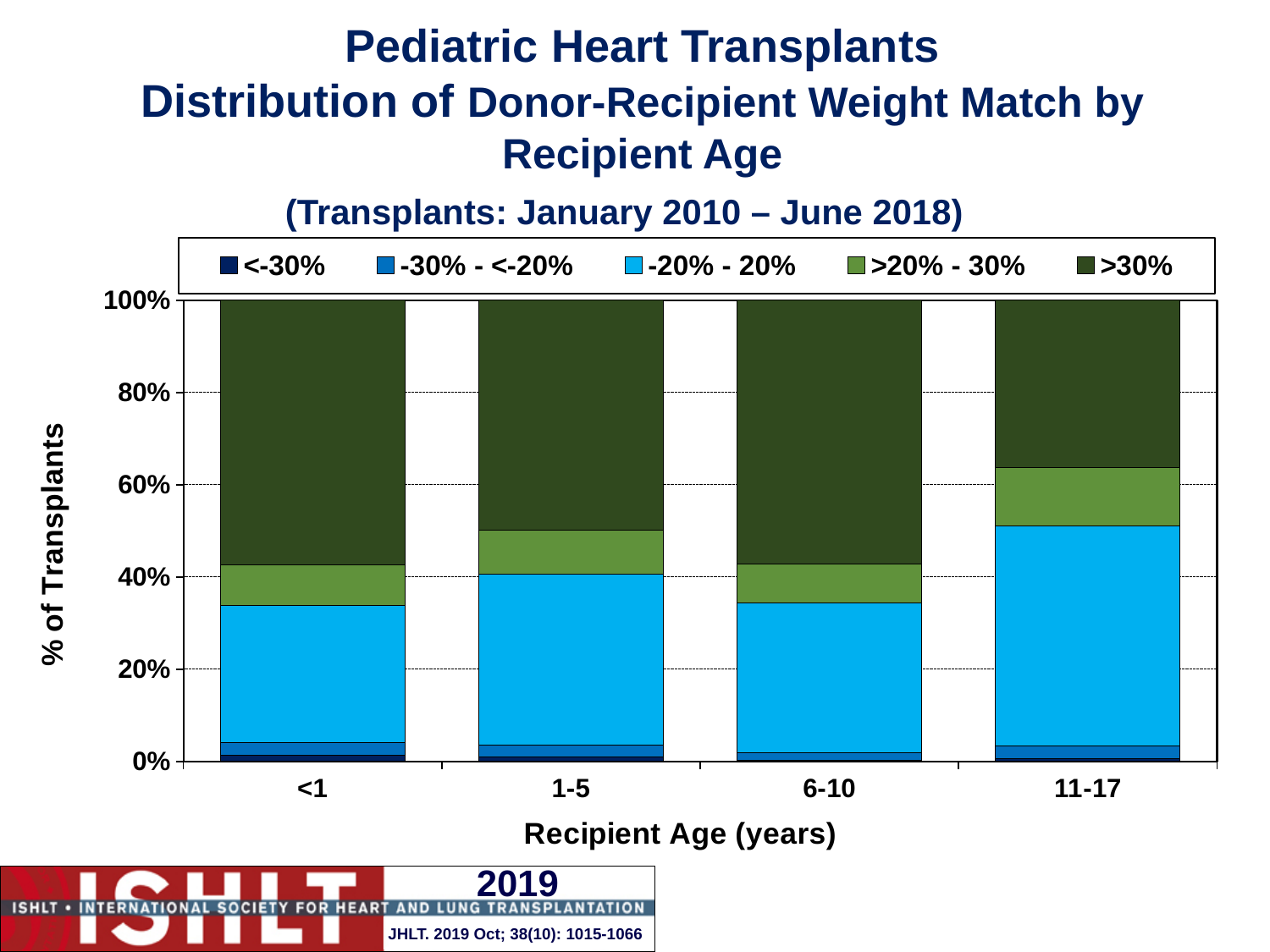
Which age group has a larger -20% - 20% share, 6-10 or 11-17? 11-17 What is the label of the y axis? % of Transplants What is the total height of each stacked bar? 100% Is the >30% share for the 6-10 age group greater or less than 50%? greater Which recipient age group has the smallest >30% share? 11-17 What kind of chart is shown on the slide? Stacked bar chart Which age group has a larger >30% share, <1 or 11-17? <1 How many series does the legend list? 5 How many recipient age groups are shown on the x axis? 4 Is the >30% share for the 11-17 age group greater or less than 40%? less Which recipient age group has the largest -20% - 20% share? 11-17 Is the >30% share for the <1 age group greater or less than 50%? greater